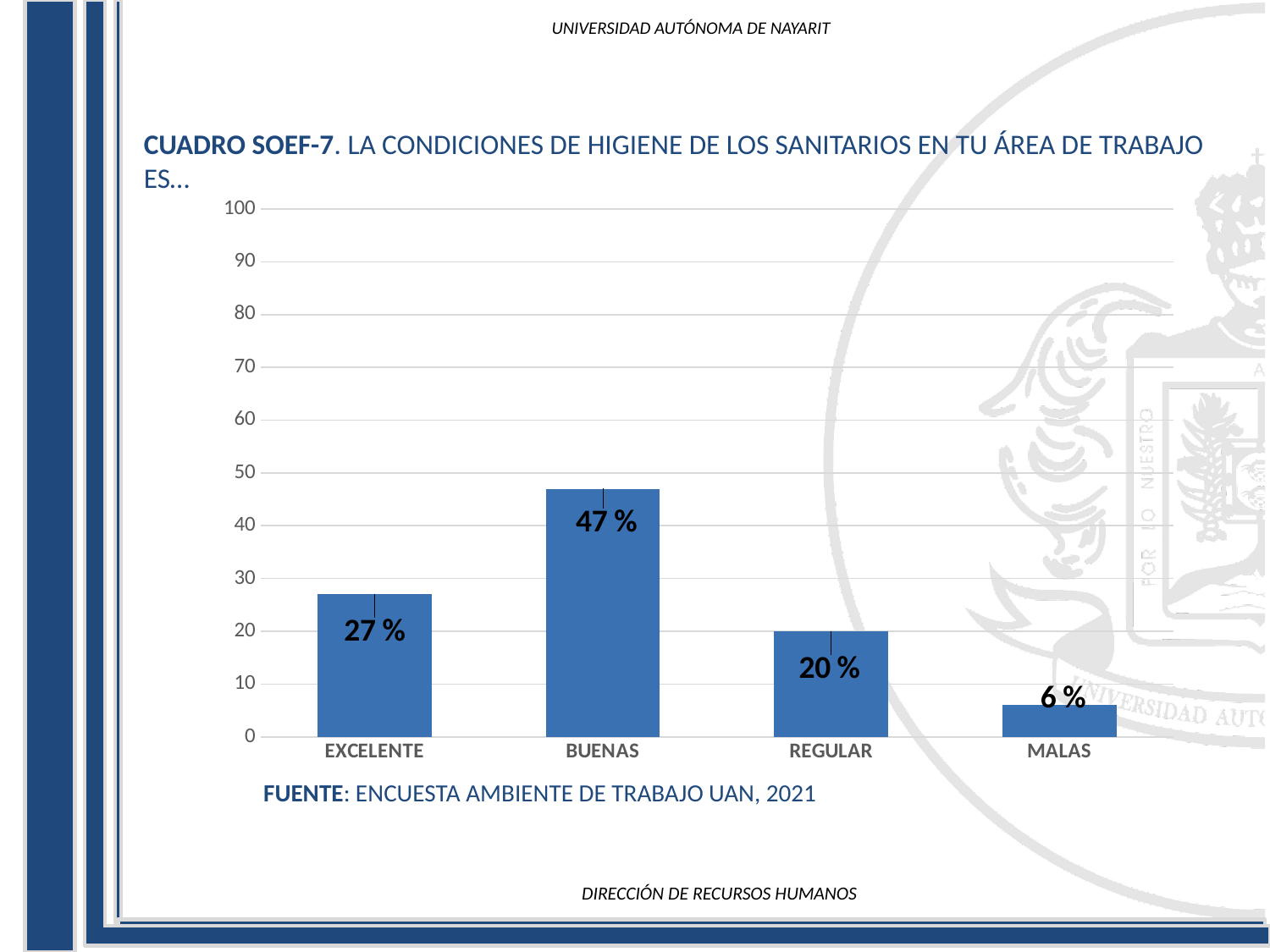
What is the source cited below the chart? ENCUESTA AMBIENTE DE TRABAJO UAN, 2021 What is the value for MALAS? 6 % What is the value for BUENAS? 47 % What is the value for EXCELENTE? 27 % What is the difference between the values for REGULAR and MALAS? 14 % How many categories are shown on the x axis? 4 Which category has the highest value? BUENAS What kind of chart is shown on the slide? Bar chart What is the value for REGULAR? 20 % What is the difference between the values for BUENAS and EXCELENTE? 20 % Which category has the lowest value? MALAS Which is larger, the value for EXCELENTE or the value for REGULAR? EXCELENTE